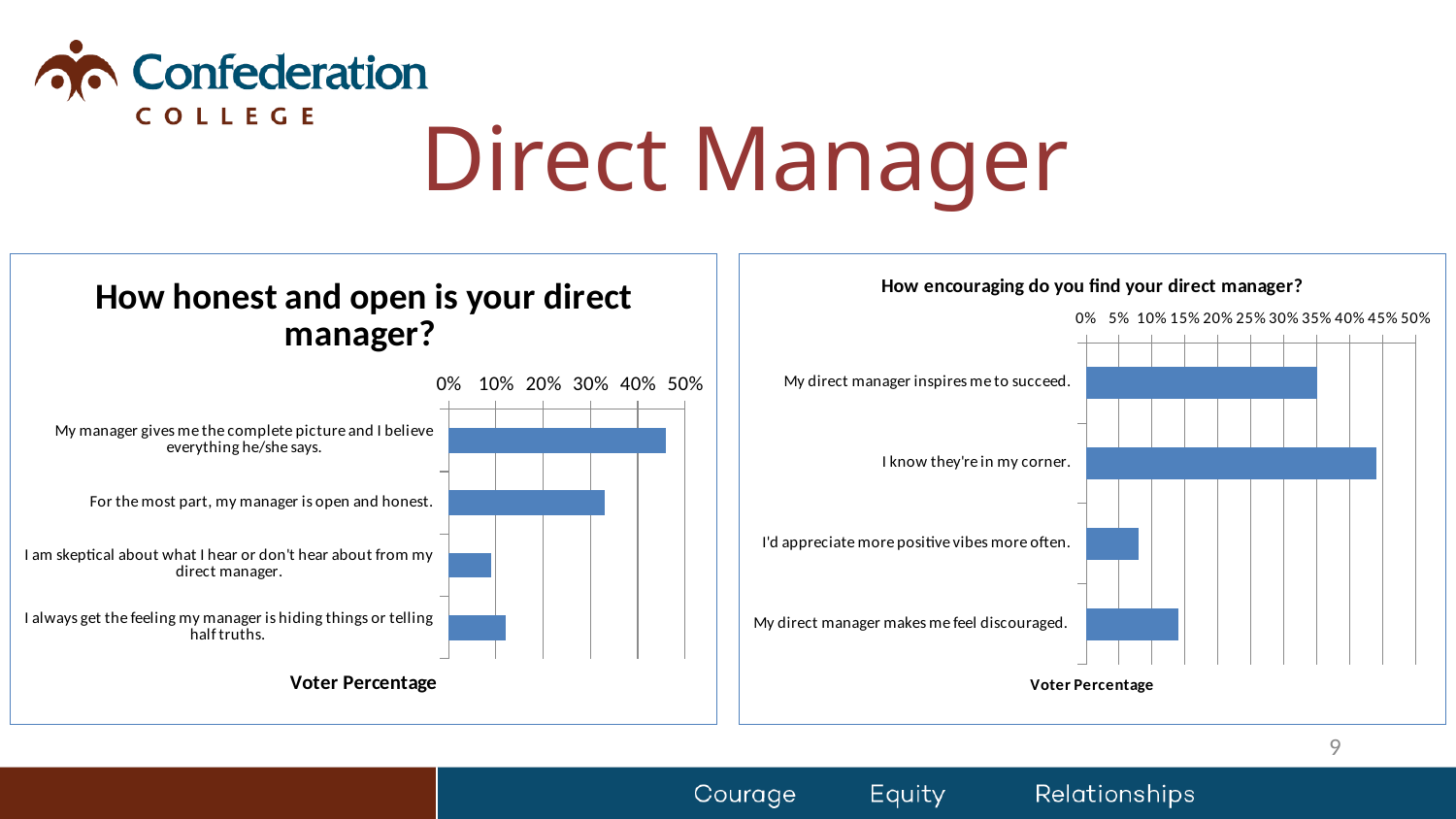
In the chart titled "How honest and open is your direct manager?", is the value for "For the most part, my manager is open and honest." greater or less than 30%? greater In the chart titled "How encouraging do you find your direct manager?", which category has the highest value? I know they're in my corner. In the chart titled "How encouraging do you find your direct manager?", which is larger: the value for "My direct manager inspires me to succeed." or the value for "My direct manager makes me feel discouraged."? My direct manager inspires me to succeed. In the chart titled "How honest and open is your direct manager?", which category has the lowest value? I am skeptical about what I hear or don't hear about from my direct manager. In the chart titled "How honest and open is your direct manager?", how many categories are plotted? 4 In the chart titled "How encouraging do you find your direct manager?", is the value for "I know they're in my corner." greater or less than 40%? greater In the chart titled "How encouraging do you find your direct manager?", what is the axis title shown below the bars? Voter Percentage In the chart titled "How encouraging do you find your direct manager?", which category has the lowest value? I'd appreciate more positive vibes more often. In the chart titled "How encouraging do you find your direct manager?", how many categories are plotted? 4 In the chart titled "How honest and open is your direct manager?", is the value for "I always get the feeling my manager is hiding things or telling half truths." greater or less than 20%? less In the chart titled "How honest and open is your direct manager?", which category has the highest value? My manager gives me the complete picture and I believe everything he/she says. In the chart titled "How honest and open is your direct manager?", what kind of chart is shown? Bar chart